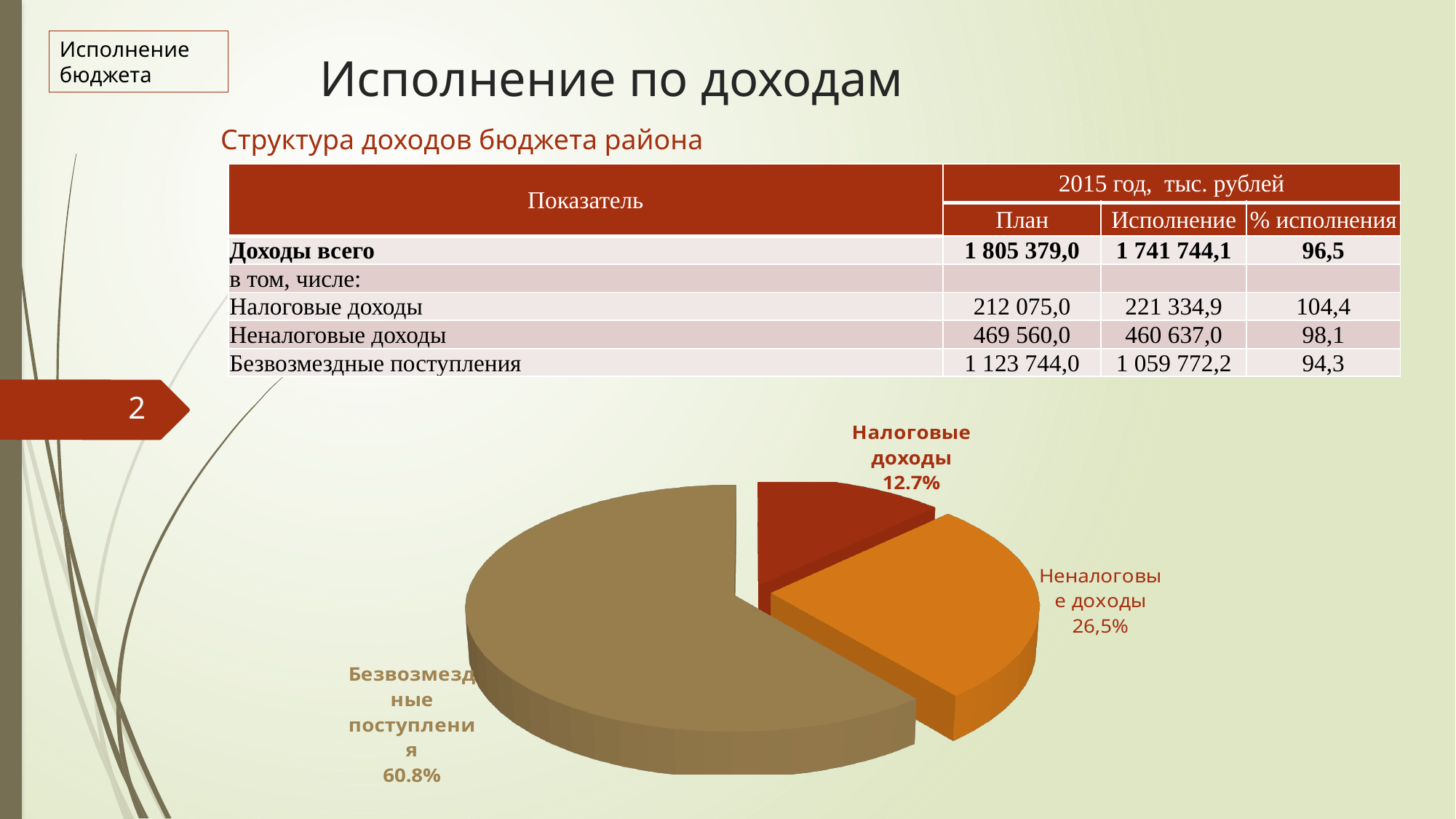
What colour is the Неналоговые доходы slice in the pie chart? orange Which is larger in the pie chart, Неналоговые доходы or Налоговые доходы? Неналоговые доходы Is the share for Безвозмездные поступления greater or less than 50%? greater What is the difference in percentage points between the Безвозмездные поступления slice and the Неналоговые доходы slice? 34.3 What share of the pie does Налоговые доходы have? 12.7% What share of the pie does Безвозмездные поступления have? 60.8% Which slice of the pie chart is the largest? Безвозмездные поступления What share of the pie does Неналоговые доходы have? 26,5% Which slice of the pie chart is the smallest? Налоговые доходы What colour is the Безвозмездные поступления slice in the pie chart? brown What kind of chart is shown on the slide? pie chart How many slices does the pie chart have? 3